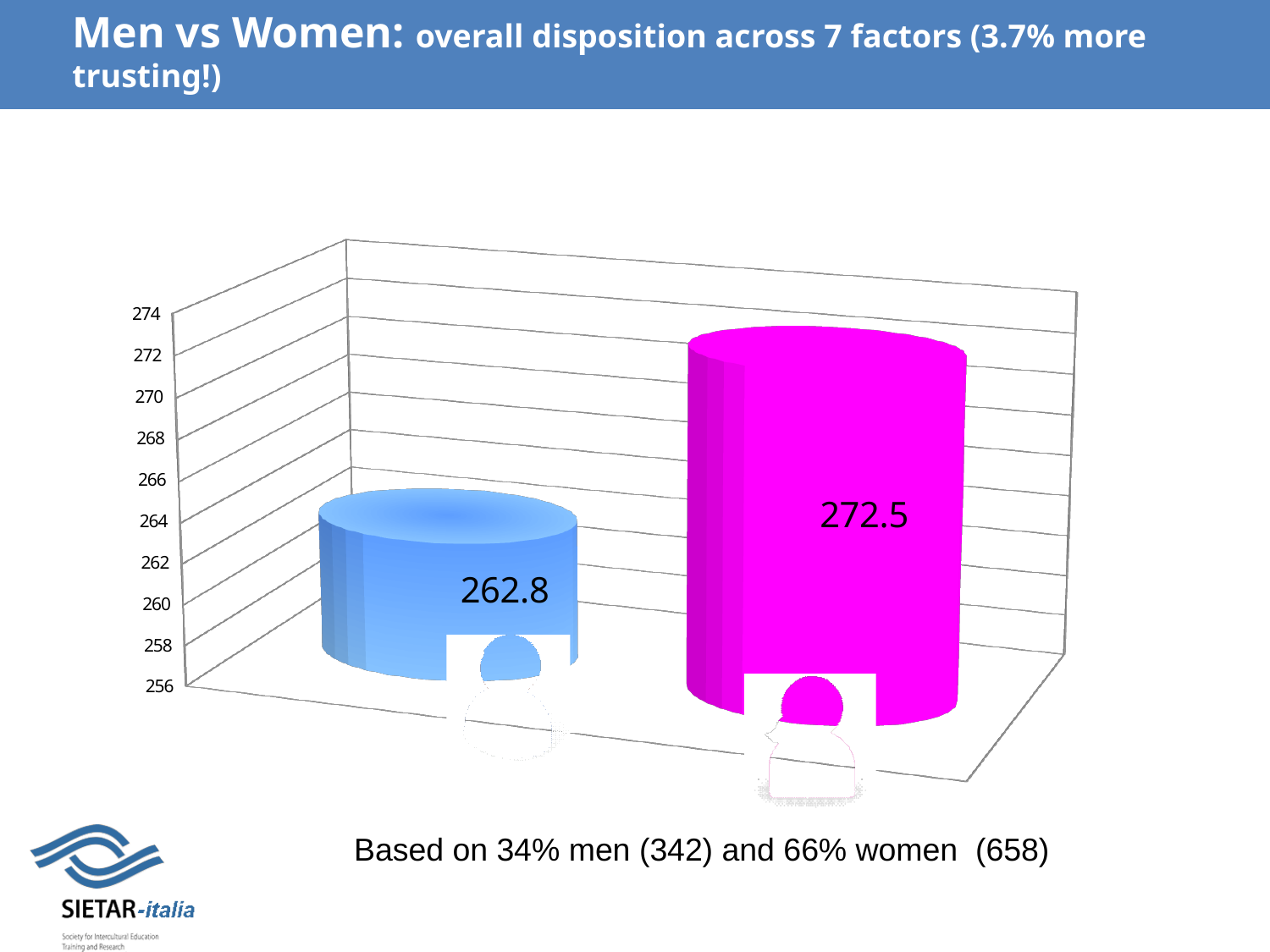
Which group has the lower overall disposition score, men or women? Men Which group has the higher overall disposition score, men or women? Women What is the lowest value labelled on the vertical axis? 256 What is the value shown for men (the blue bar)? 262.8 What is the difference between the women's value and the men's value? 9.7 Is the value for women greater or less than 270? greater Is the value for men greater or less than 266? less What is the value shown for women (the magenta bar)? 272.5 What colour is the bar representing women? Magenta What kind of chart is shown on the slide? Bar chart How many bars are plotted in the chart? 2 Is the value for the blue bar larger or smaller than the value for the magenta bar? Smaller